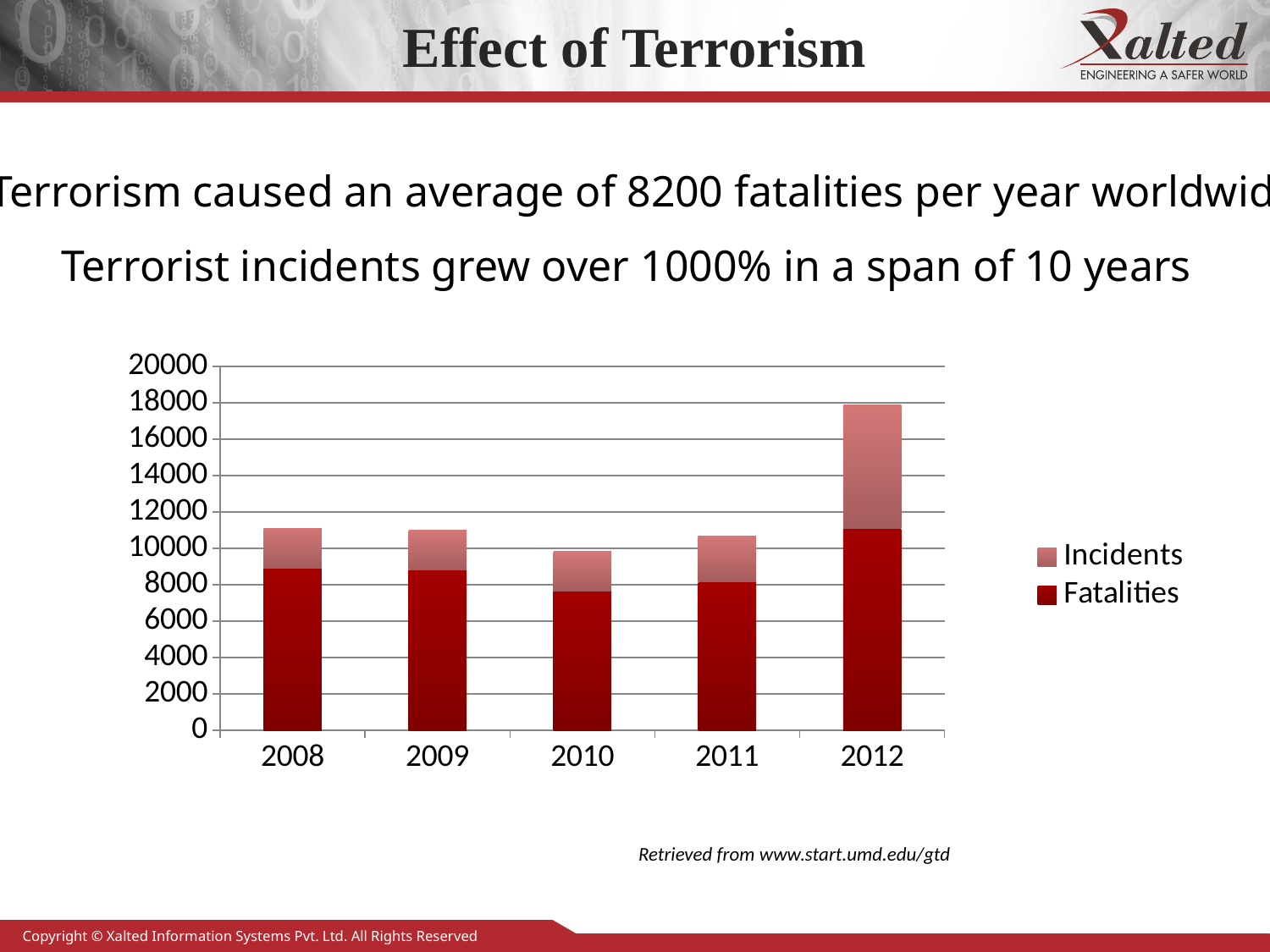
How many series does the chart legend list? 2 Which year has the shortest stacked bar in the chart? 2010 Is the Fatalities value for 2010 greater or less than 8000? less Is the total stacked value for 2012 greater or less than 16000? greater Is the Fatalities value for 2012 greater or less than 10000? greater Which year has the larger total stacked bar, 2010 or 2012? 2012 What are the two series named in the chart legend? Incidents and Fatalities How many years are shown on the x axis of the chart? 5 What kind of chart is shown on the slide? Stacked bar chart Which year has the tallest stacked bar in the chart? 2012 Which year has the highest Fatalities value? 2012